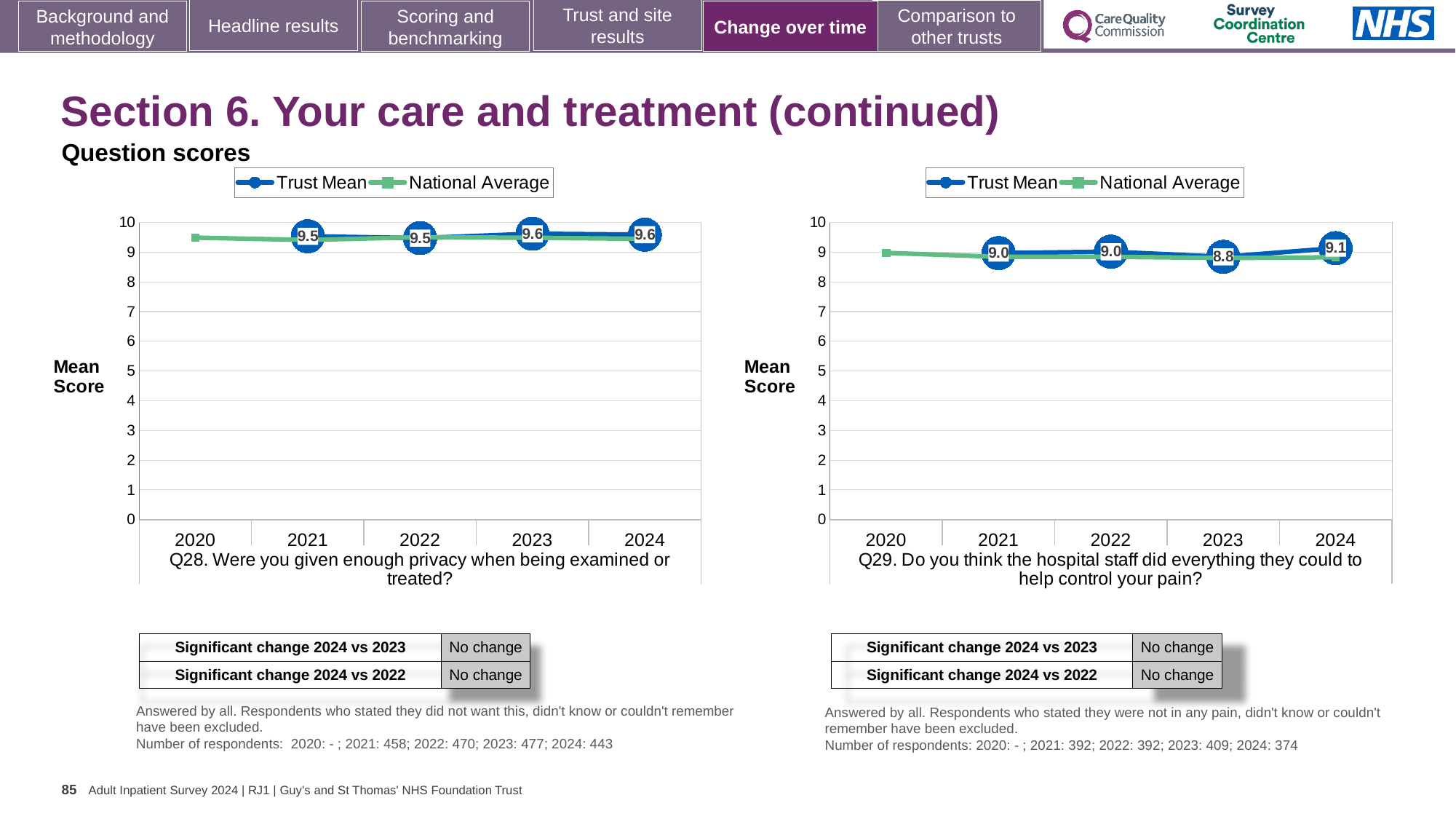
In the Q28 chart (left), what is the Trust Mean score for 2021? 9.5 How many series does the legend of the Q29 chart (right) list? 2 How many years are shown on the x axis of the Q28 chart (left)? 5 In the Q28 chart (left), what is the Trust Mean score for 2024? 9.6 In the Q29 chart (right), what is the Trust Mean score for 2024? 9.1 In the Q29 chart (right), which year has the lowest Trust Mean score? 2023 In the Q29 chart (right), what is the Trust Mean score for 2023? 8.8 In the Q29 chart (right), which year has the highest Trust Mean score? 2024 In the Q28 chart (left), is the Trust Mean score for 2023 larger or smaller than the Trust Mean score for 2022? larger In the Q29 chart (right), what is the difference between the Trust Mean scores for 2024 and 2023? 0.3 What kind of chart is the Q28 chart (left)? line chart In the Q29 chart (right), is the National Average value for 2020 greater or less than 8? greater